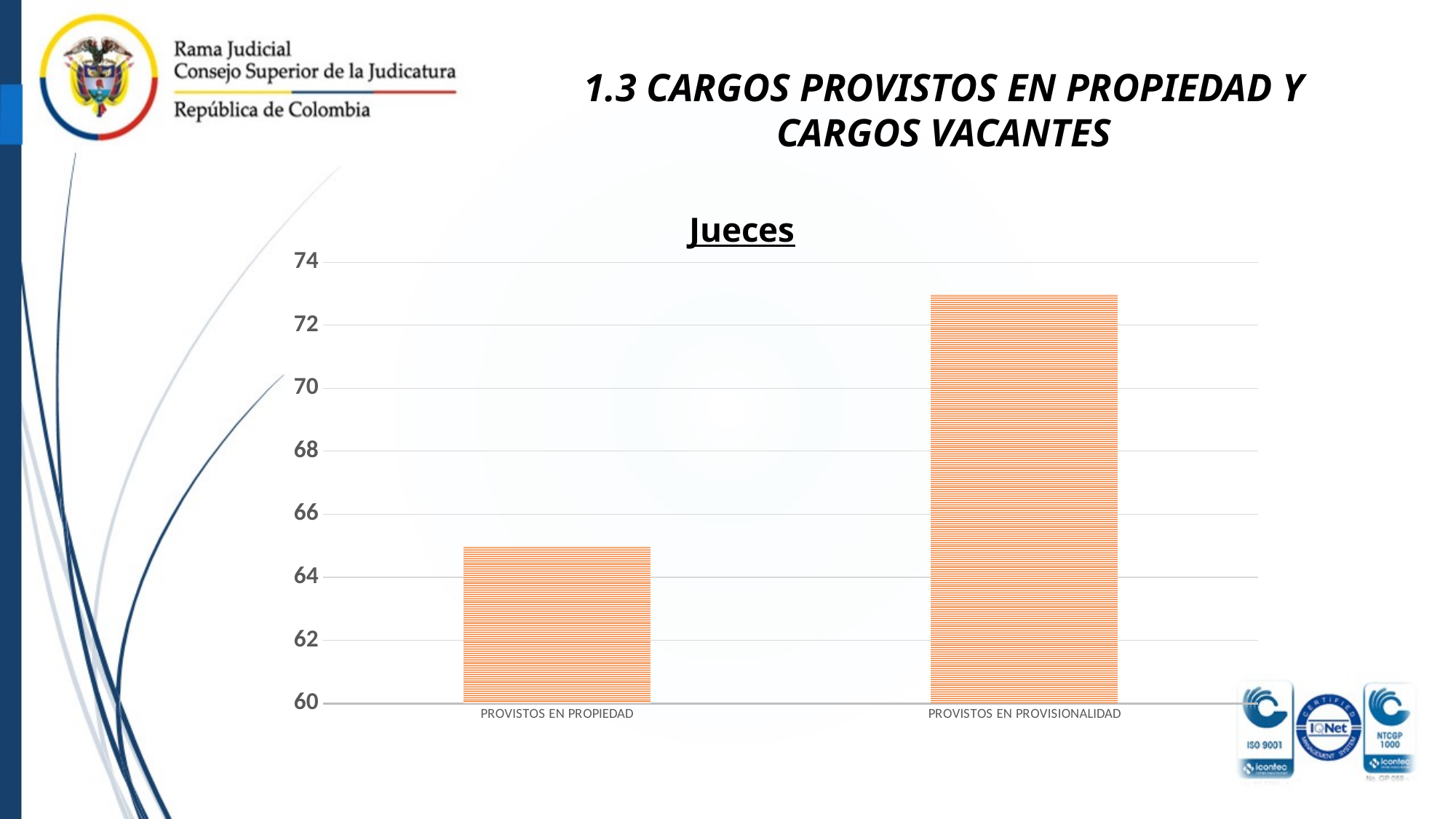
What kind of chart is shown on the slide? bar chart Which category has the lowest value? PROVISTOS EN PROPIEDAD Is the value for PROVISTOS EN PROPIEDAD greater or less than 64? greater Do the values rise or fall from left to right across the categories? rise What is the lowest value shown on the vertical axis? 60 Is the value for PROVISTOS EN PROVISIONALIDAD greater or less than 72? greater How many categories are plotted in the chart? 2 Is the value for PROVISTOS EN PROVISIONALIDAD greater or less than 74? less Which category has the highest value? PROVISTOS EN PROVISIONALIDAD What is the title of the chart? Jueces Which is larger, the value for PROVISTOS EN PROPIEDAD or the value for PROVISTOS EN PROVISIONALIDAD? PROVISTOS EN PROVISIONALIDAD